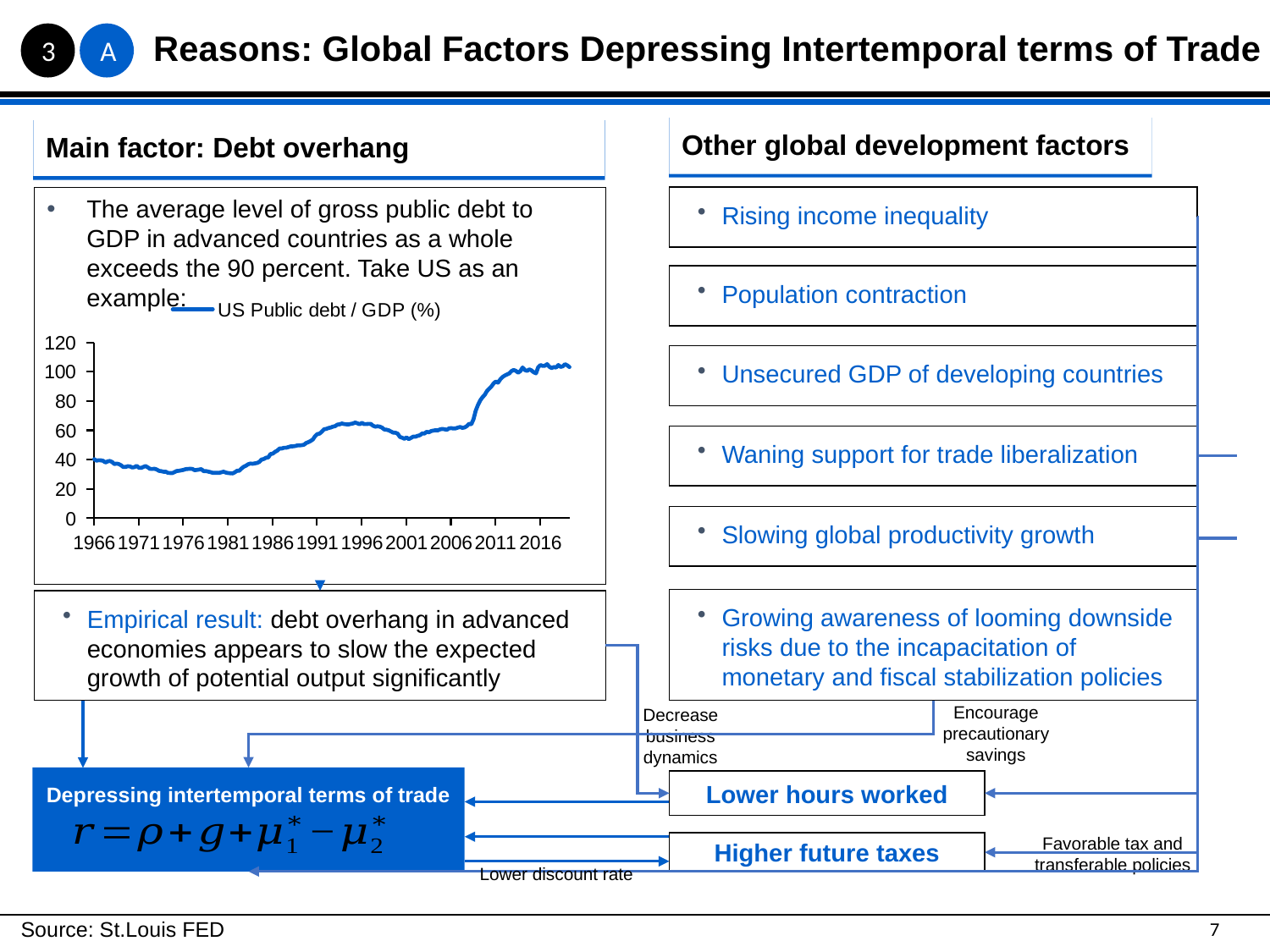
How many year labels are shown on the x axis of the chart? 11 How many series does the chart legend list? 1 What is the name of the series shown in the chart legend? US Public debt / GDP (%) Is the value of US Public debt / GDP (%) in 1966 greater or less than 60? less Is the value of US Public debt / GDP (%) in 1981 greater or less than 40? less What is the highest value shown on the y axis of the chart? 120 Is the value of US Public debt / GDP (%) in 2016 greater or less than 80? greater Which is larger, US Public debt / GDP (%) in 2011 or in 1981? 2011 What kind of chart is shown on the slide? line chart Overall, does US Public debt / GDP (%) rise or fall between 1966 and 2016? rise What colour is the line plotted in the chart? blue